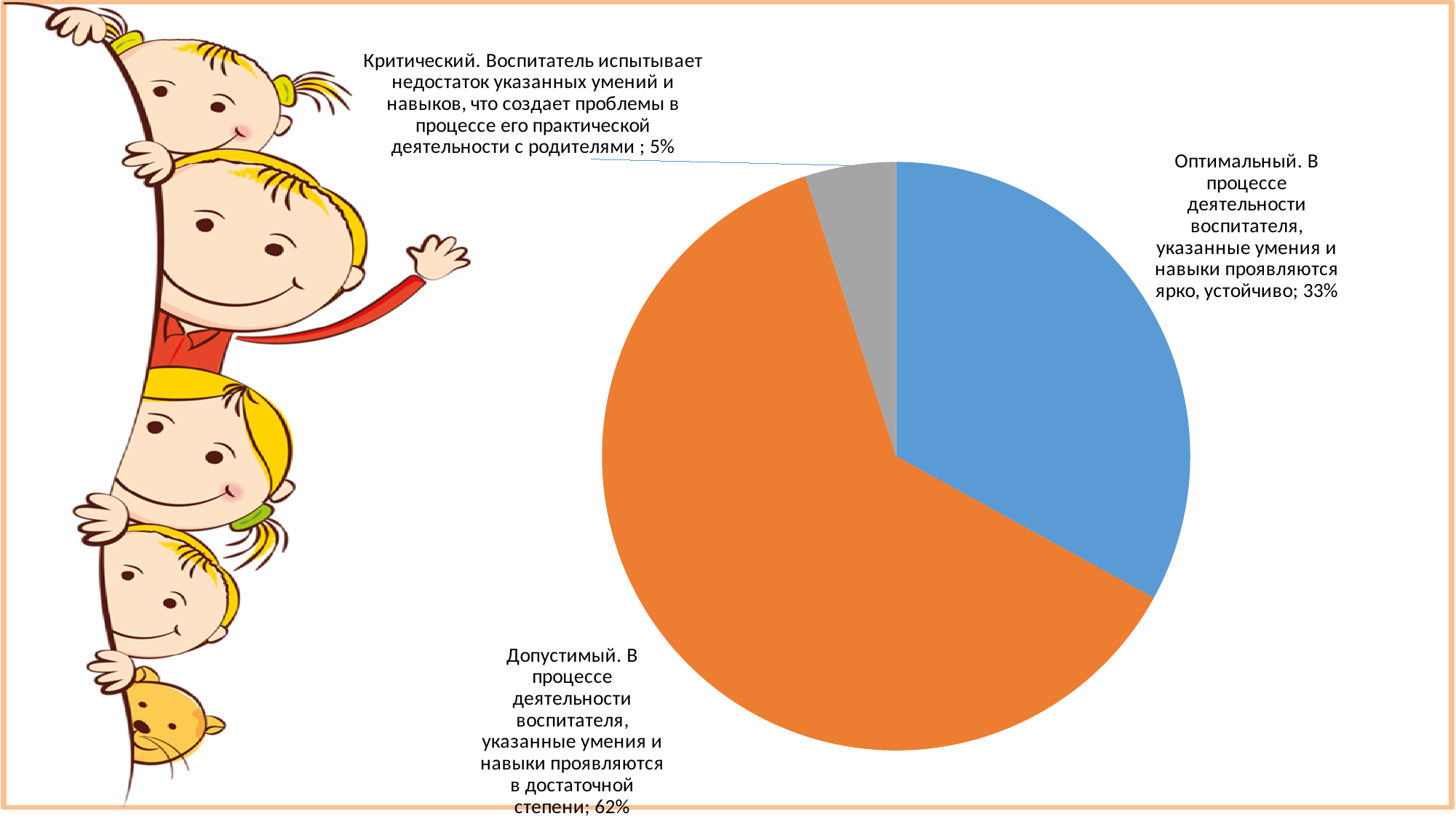
What percentage is shown for the 'Критический' level? 5% What percentage is shown for the 'Оптимальный' level? 33% Which is larger, the share for 'Оптимальный' or the share for 'Критический'? Оптимальный What colour is the slice for the 'Допустимый' level? orange What is the difference in percentage points between the 'Оптимальный' and 'Критический' levels? 28 What colour is the slice for the 'Оптимальный' level? blue Which level has the largest share of the pie? Допустимый What kind of chart is shown on the slide? pie chart Which level has the smallest share of the pie? Критический What percentage is shown for the 'Допустимый' level? 62% What is the difference in percentage points between the 'Допустимый' and 'Оптимальный' levels? 29 How many slices does the pie chart have? 3